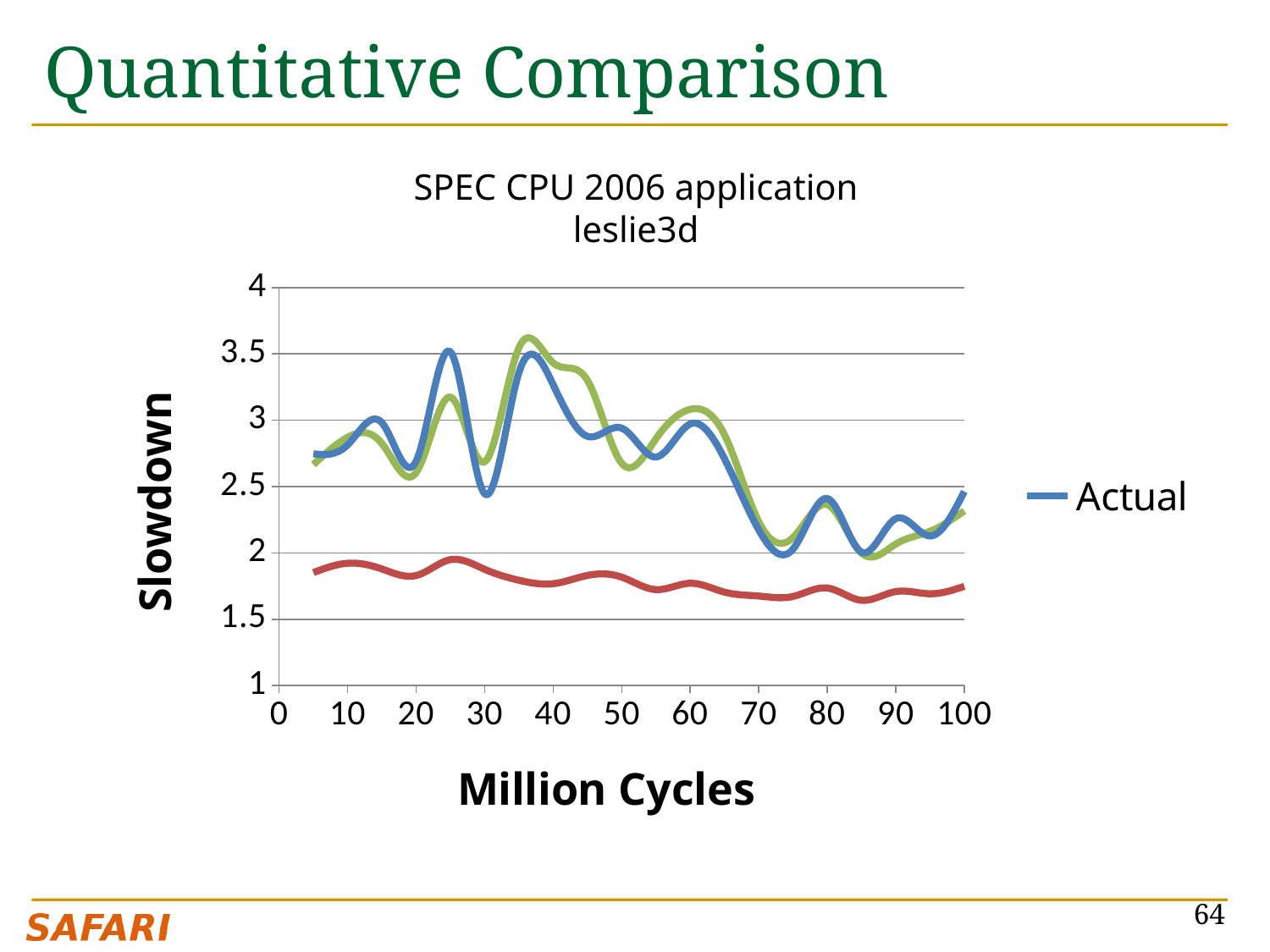
Is the Actual value at 40 million cycles greater or less than 3? greater How many series does the chart's legend list? 1 Does the Actual series generally rise or fall from 60 to 75 million cycles? fall Is the Actual value at 10 million cycles greater or less than 2.5? greater What kind of chart is shown on the slide? line chart Is the Actual value at 90 million cycles greater or less than 2.5? less What is the title of the chart? SPEC CPU 2006 application leslie3d What is the label of the y axis? Slowdown Which is larger at 40 million cycles: the Actual value or the value of the red line? Actual